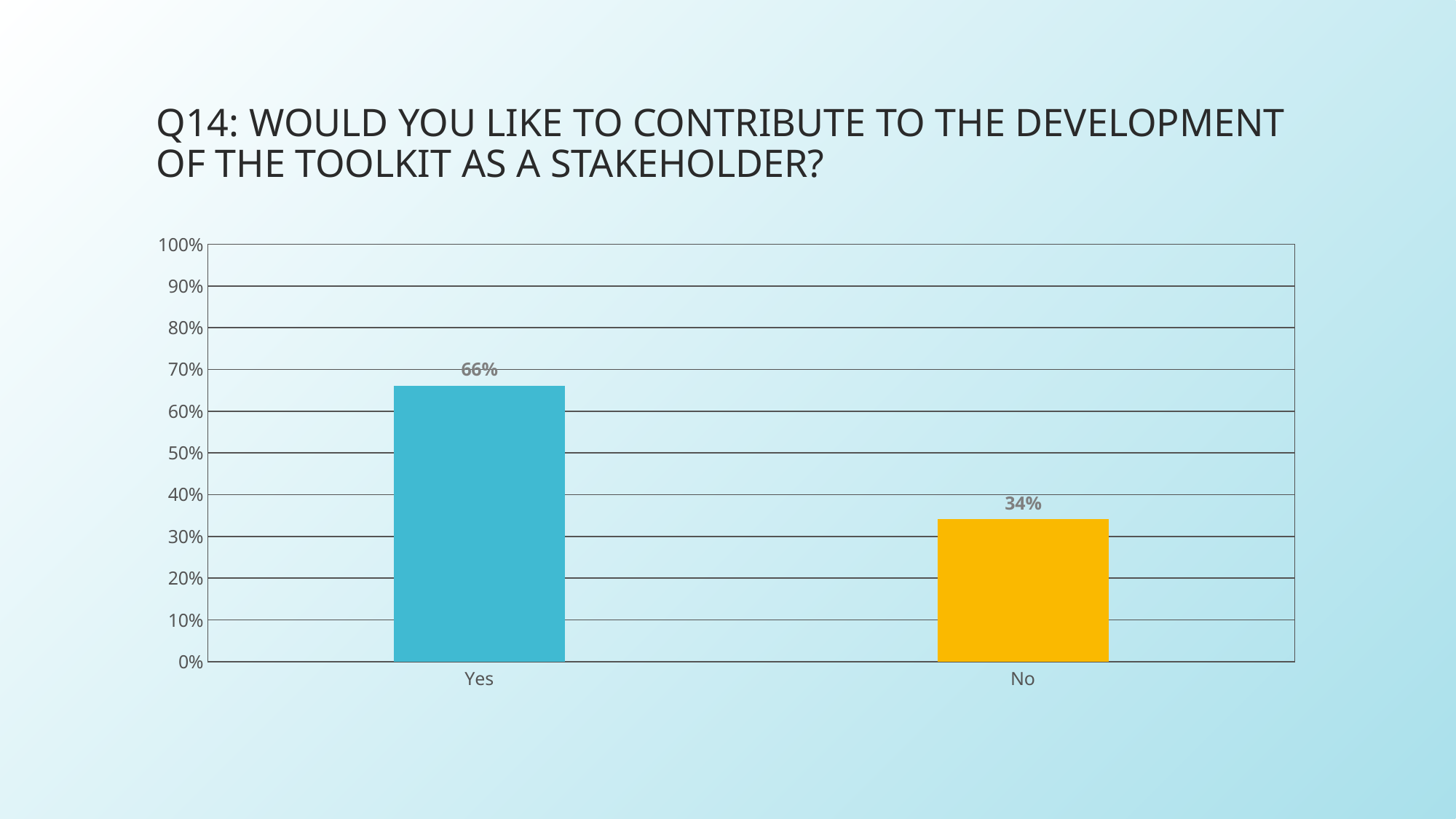
What percentage of respondents answered Yes? 66% What is the difference between the Yes and No percentages? 32% Which is larger, the value for Yes or the value for No? Yes What is the maximum value shown on the y axis? 100% Is the value for Yes greater or less than 50%? greater What percentage of respondents answered No? 34% Which response has the lowest value? No What colour is the bar for No? Yellow How many response categories are shown on the x axis? 2 What kind of chart is shown on the slide? Bar chart Which response has the highest value? Yes Is the value for No greater or less than 40%? less